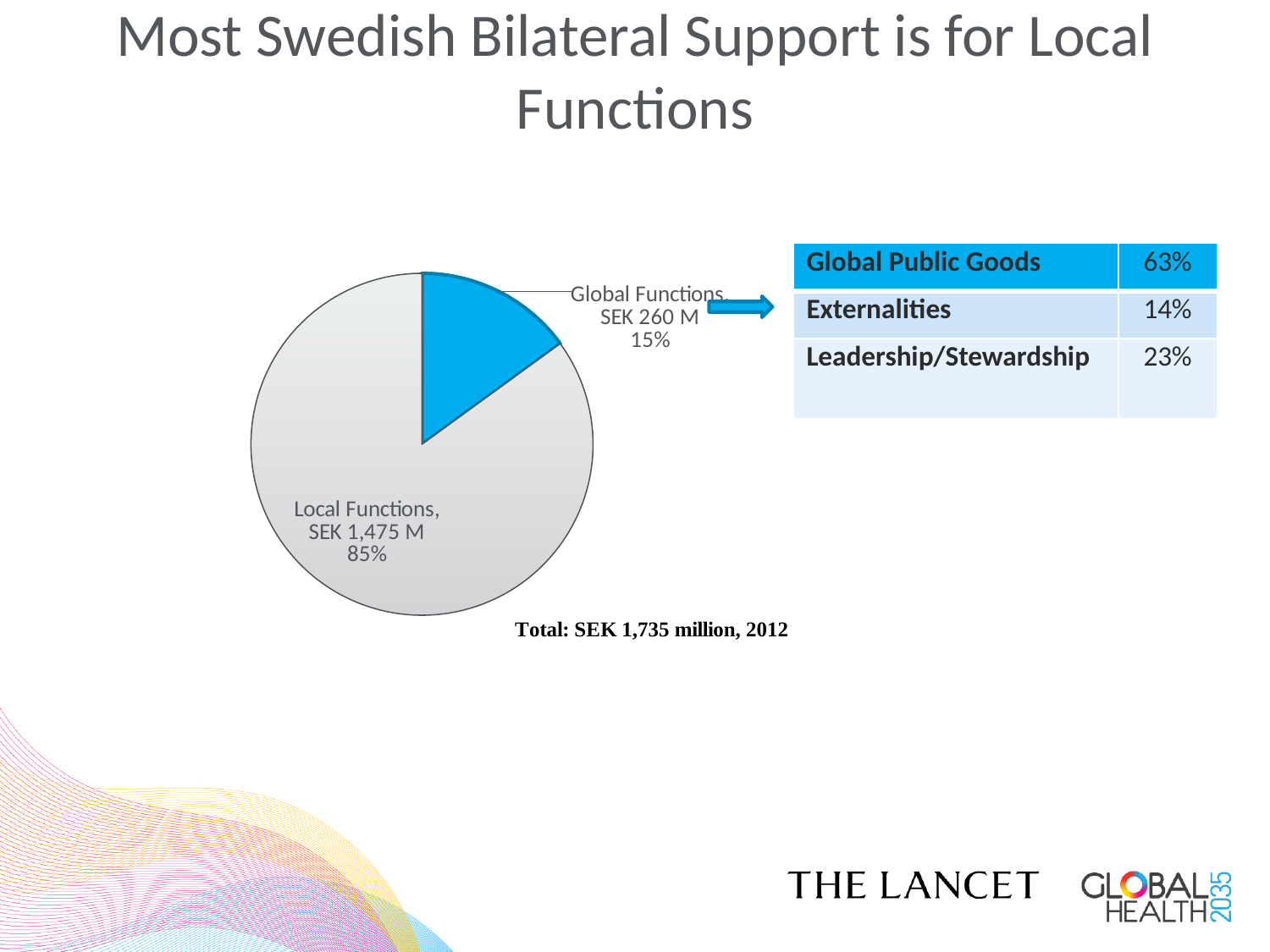
What share of the pie does Global Functions represent? 15% What is the value for Global Functions in the pie chart? SEK 260 M What share of the pie does Local Functions represent? 85% What kind of chart is shown on the slide? pie chart What is the value for Local Functions in the pie chart? SEK 1,475 M What colour is the Global Functions slice in the pie chart? blue How many slices does the pie chart have? 2 What is the difference in SEK millions between Local Functions and Global Functions? SEK 1,215 M Which is larger, Local Functions or Global Functions? Local Functions Which slice of the pie chart is the largest? Local Functions Which slice of the pie chart is the smallest? Global Functions What total is stated below the pie chart? SEK 1,735 million, 2012